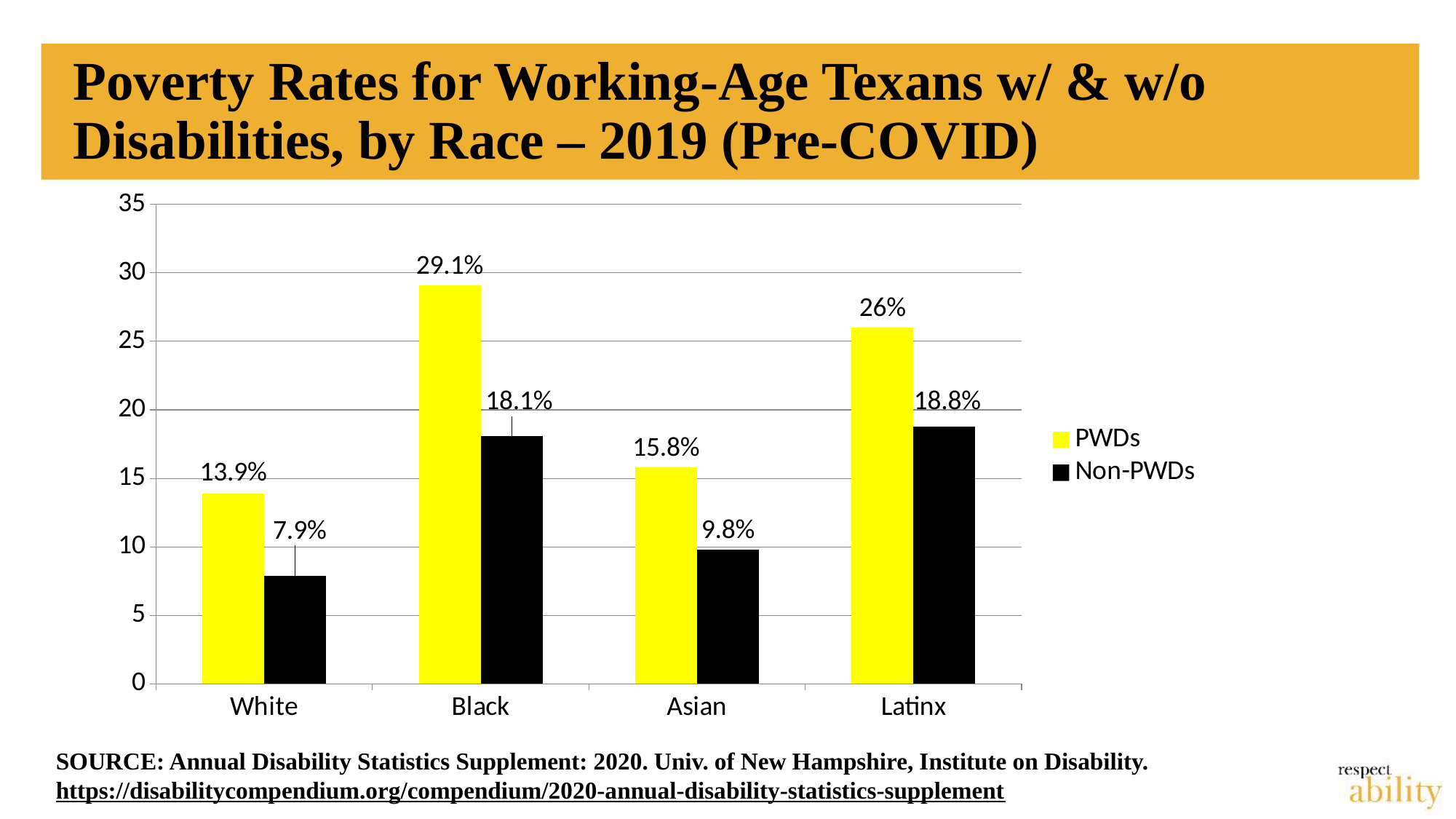
Which race has the lowest poverty rate for Non-PWDs? White What kind of chart is shown on the slide? Bar chart How many series does the legend list? 2 How many race categories are shown on the x axis? 4 What colour are the PWDs bars? Yellow What is the poverty rate for White Non-PWDs? 7.9% Which is larger: the PWDs poverty rate for Latinx or for Asian Texans? Latinx What is the poverty rate for Latinx Non-PWDs? 18.8% Which race has the highest poverty rate for PWDs? Black Is the value for Black Non-PWDs greater or less than 20? less What is the difference between the PWDs and Non-PWDs poverty rates for Asian Texans? 6 percentage points What is the poverty rate for Black PWDs? 29.1%